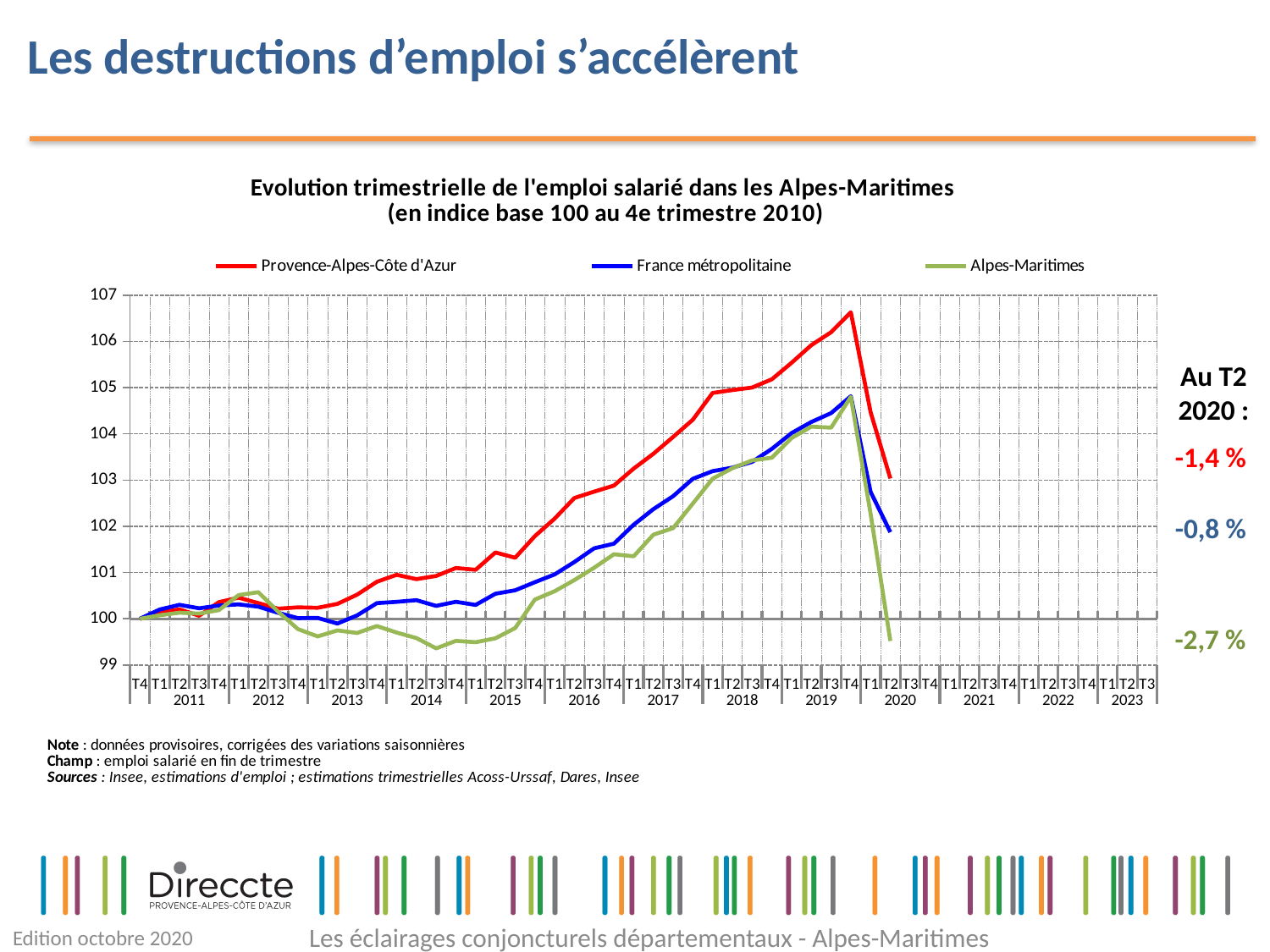
According to the annotation on the right, what is the change at T2 2020 for Alpes-Maritimes (green)? -2,7 % Is the value for Alpes-Maritimes at T2 2020 greater or less than 100? less Which series has the highest value at T4 2019? Provence-Alpes-Côte d'Azur Is the value for Provence-Alpes-Côte d'Azur at T4 2019 greater or less than 106? greater Is the value for France métropolitaine at T2 2020 greater or less than 101? greater At T2 2020, which is higher: France métropolitaine or Alpes-Maritimes? France métropolitaine How many series does the legend list? 3 According to the annotation on the right, what is the change at T2 2020 for France métropolitaine (blue)? -0,8 % Between 2015 and T4 2019, do the values for Provence-Alpes-Côte d'Azur rise or fall? rise What kind of chart is shown on the slide? line chart Which series has the lowest value at T2 2020? Alpes-Maritimes